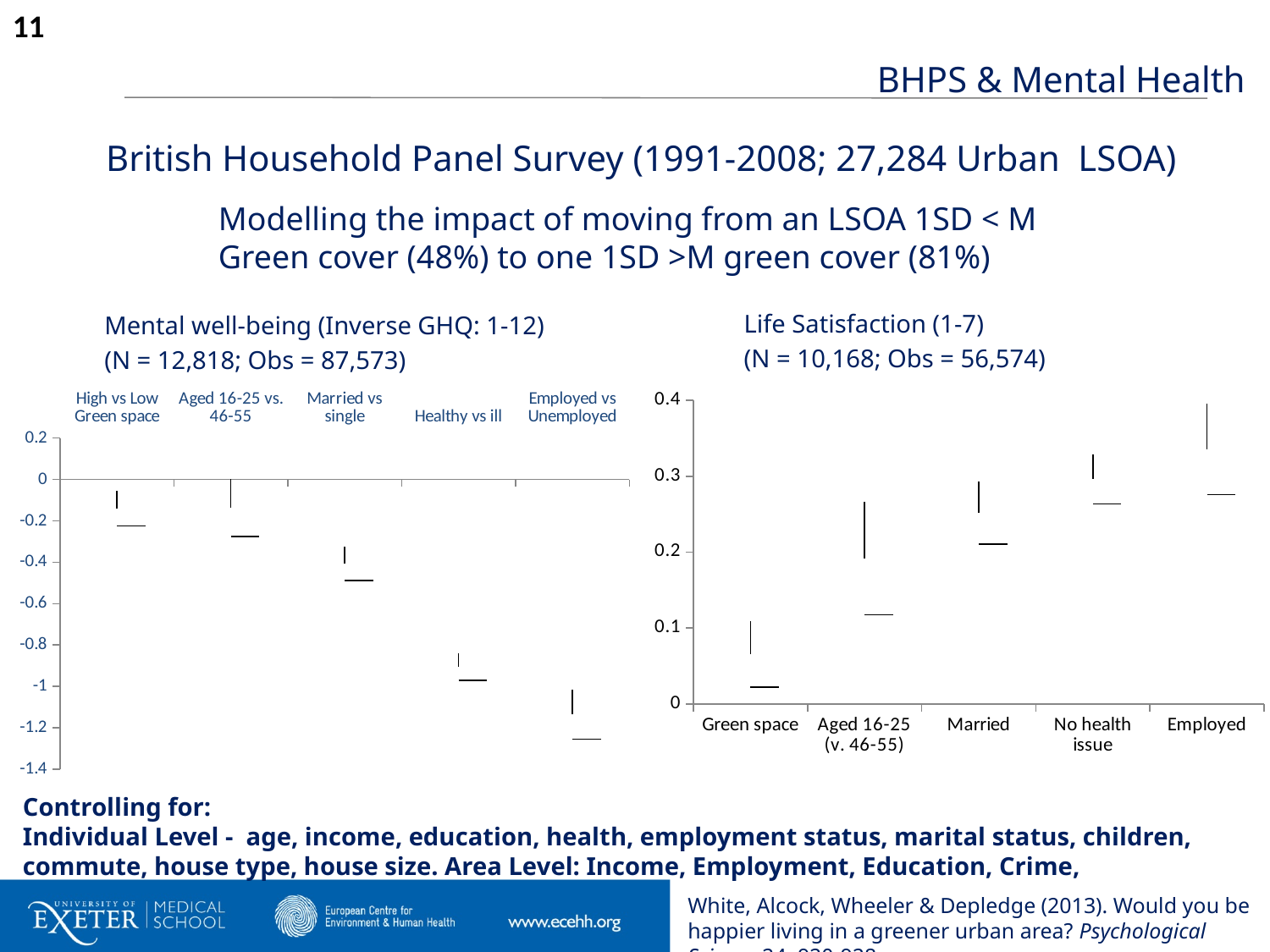
In the Mental well-being chart on the left, is the value for High vs Low Green space greater or less than -0.4? greater In the Life Satisfaction chart on the right, how many categories are plotted along the x axis? 5 In the Life Satisfaction chart on the right, which category has the lowest plotted value? Green space In the Mental well-being chart on the left, which category has the lowest plotted value? Employed vs Unemployed In the Life Satisfaction chart on the right, what is the highest value shown on the y axis? 0.4 In the Mental well-being chart on the left, do the plotted values rise or fall moving from left to right along the x axis? fall In the Mental well-being (Inverse GHQ) chart on the left, how many categories are plotted along the x axis? 5 In the Mental well-being chart on the left, which is larger: the value for Married vs single or the value for Healthy vs ill? Married vs single In the Life Satisfaction chart on the right, is the value for Green space greater or less than 0.1? less In the Mental well-being chart on the left, is the value for Healthy vs ill greater or less than -0.8? less In the Life Satisfaction chart on the right, which is larger: the value for Married or the value for Green space? Married